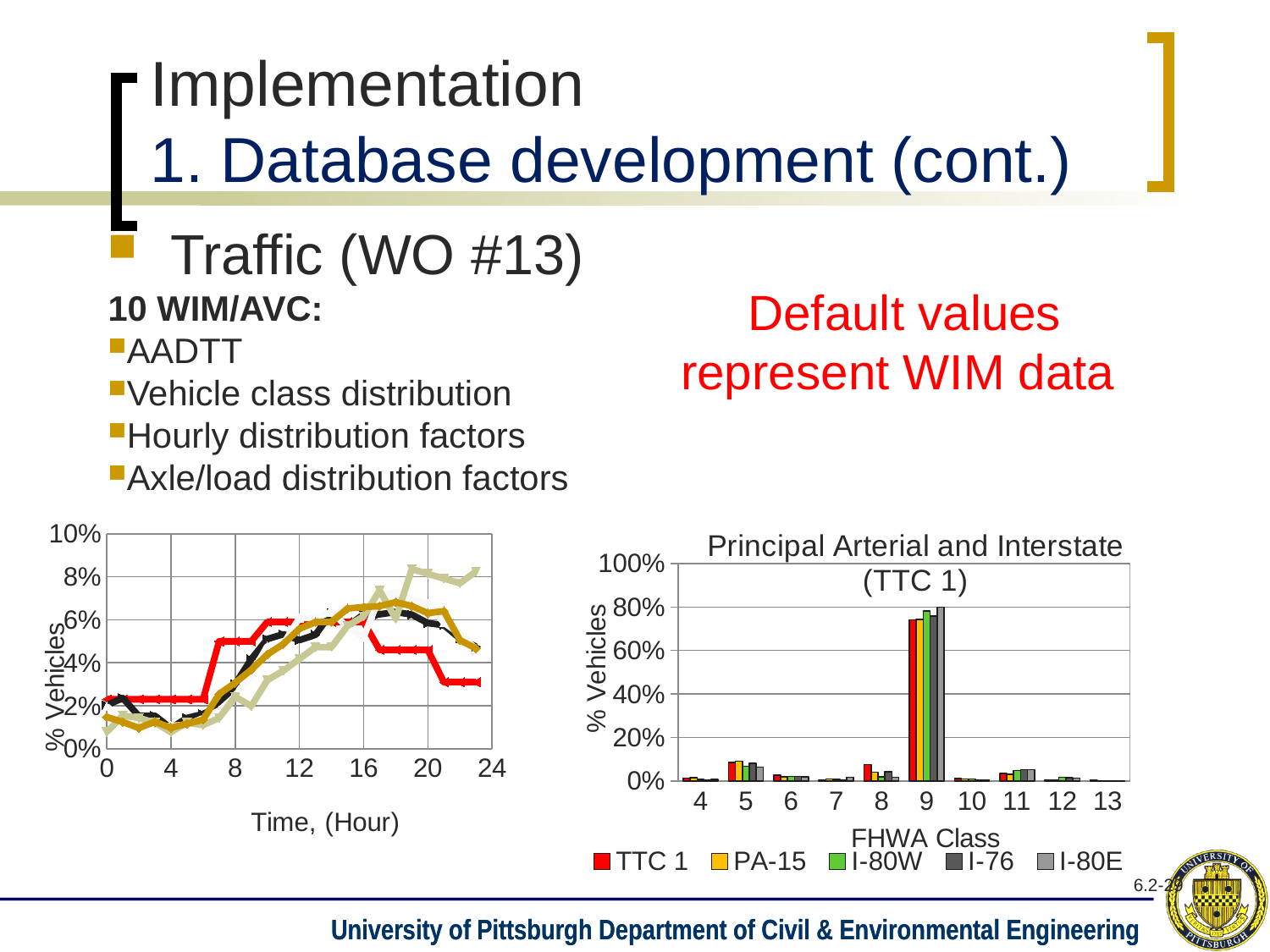
In the 'Principal Arterial and Interstate (TTC 1)' chart, how many series does the legend list? 5 In the 'Principal Arterial and Interstate (TTC 1)' chart, which is larger: the value for TTC 1 at FHWA Class 9 or at FHWA Class 5? FHWA Class 9 In the 'Principal Arterial and Interstate (TTC 1)' chart, what is the first series listed in the legend? TTC 1 What kind of chart is the chart on the right titled 'Principal Arterial and Interstate (TTC 1)'? bar chart In the 'Principal Arterial and Interstate (TTC 1)' chart, which FHWA Class has the highest % Vehicles? 9 In the line chart on the left, is the value of the red line at hour 0 greater or less than 4%? less In the 'Principal Arterial and Interstate (TTC 1)' chart, what is the label of the x axis? FHWA Class In the line chart on the left, do the values generally rise or fall between hour 0 and hour 16? rise In the 'Principal Arterial and Interstate (TTC 1)' chart, is the value for TTC 1 at FHWA Class 9 greater or less than 60%? greater In the 'Principal Arterial and Interstate (TTC 1)' chart, how many FHWA Class categories are shown on the x axis? 10 In the 'Principal Arterial and Interstate (TTC 1)' chart, is the value for PA-15 at FHWA Class 5 greater or less than 20%? less What kind of chart is the chart on the left with 'Time, (Hour)' on the x axis? line chart